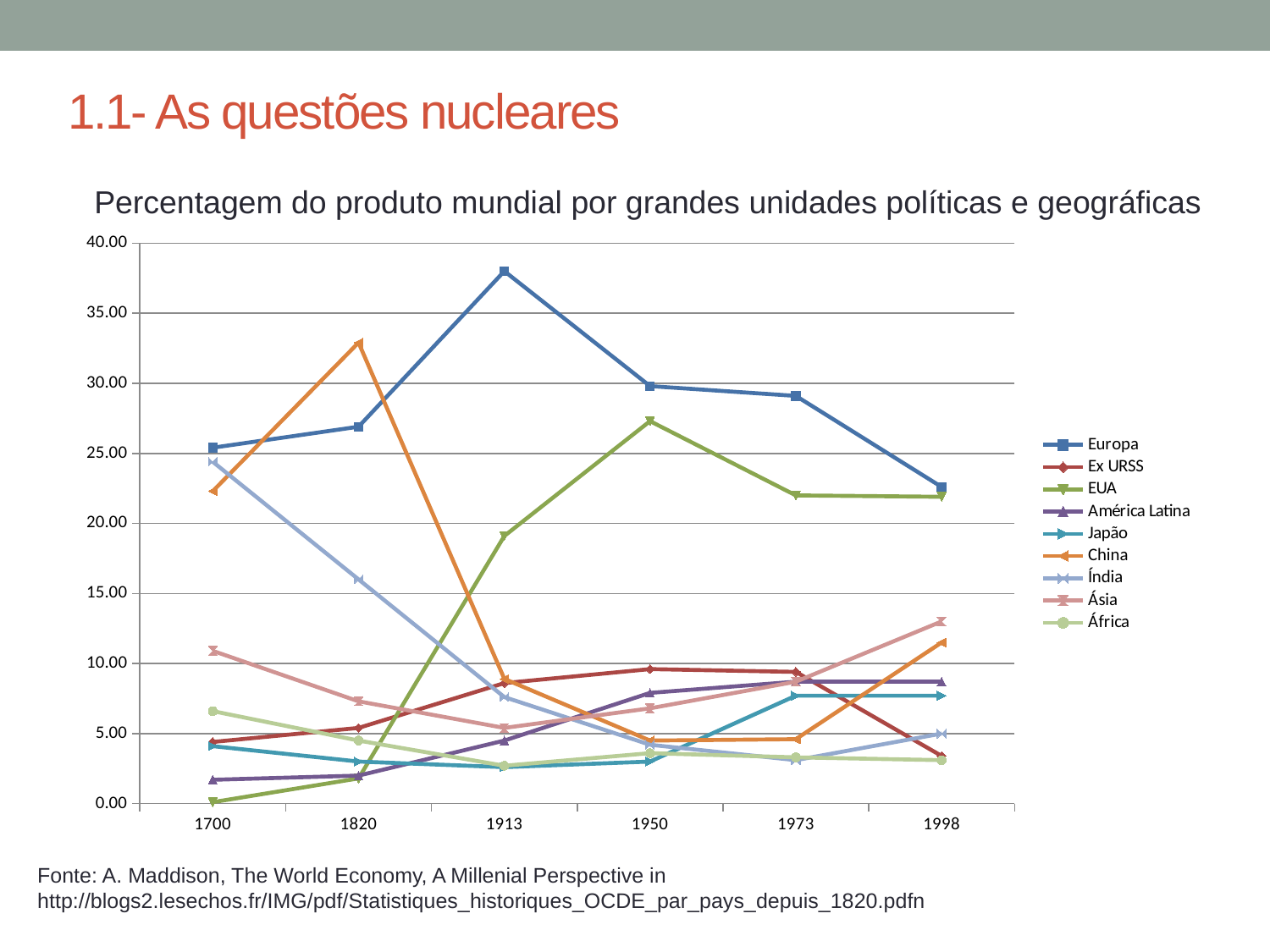
How many series does the legend list? 9 In 1950, which is larger: the value for Europa or the value for EUA? Europa Which series has the highest value in 1820? China What kind of chart is shown on the slide? line chart Is the value for Europa in 1913 greater or less than 35.00? greater Which series has the highest value in 1913? Europa Is the value for China in 1820 greater or less than 30.00? greater How many years are shown along the x axis? 6 Is the value for Índia in 1973 greater or less than 5.00? less Does the value for Europa rise or fall from 1913 to 1998? fall What is the title of the chart? Percentagem do produto mundial por grandes unidades políticas e geográficas Which series has the lowest value in 1700? EUA